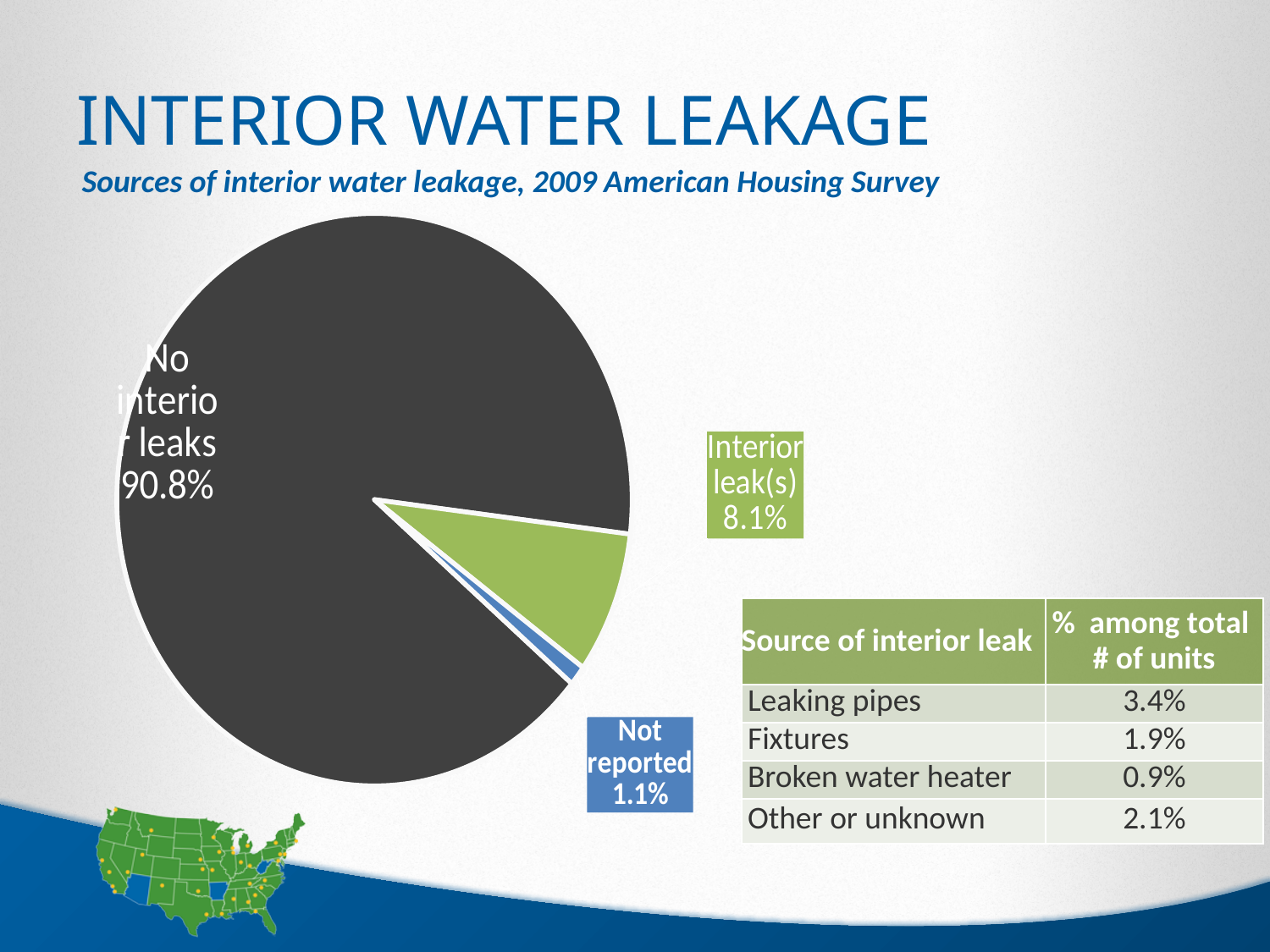
What share of the pie is labelled "No interior leaks"? 90.8% What share of the pie is labelled "Not reported"? 1.1% Which slice of the pie chart is the smallest? Not reported How many slices does the pie chart have? 3 What is the subtitle printed above the pie chart? Sources of interior water leakage, 2009 American Housing Survey Which is larger in the pie chart: Interior leak(s) or Not reported? Interior leak(s) What kind of chart is shown on the slide? pie chart What colour is the "Interior leak(s)" slice of the pie chart? green Which slice of the pie chart is the largest? No interior leaks What is the difference in percentage points between the "No interior leaks" slice and the "Interior leak(s)" slice? 82.7 What share of the pie is labelled "Interior leak(s)"? 8.1% What is the difference in percentage points between the "Interior leak(s)" slice and the "Not reported" slice? 7.0